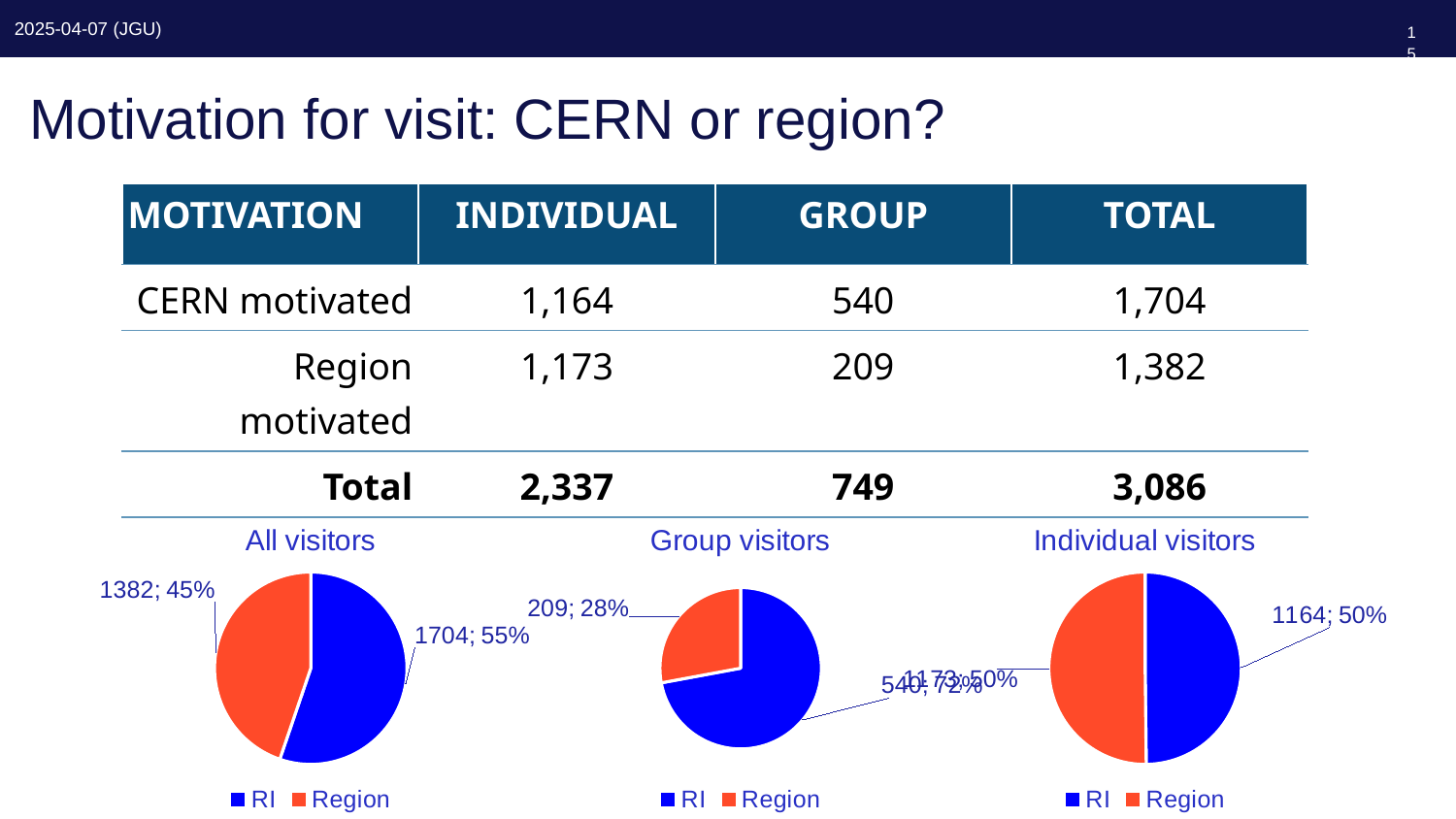
In the "All visitors" pie chart, what is the difference between the RI value and the Region value? 322 In the "All visitors" pie chart, what share of the pie is Region? 45% What kind of chart is the "All visitors" chart? pie chart In the "Group visitors" pie chart, which slice is the largest? RI In the "All visitors" pie chart, what colour represents RI? blue In the "All visitors" pie chart, what is the value for RI? 1704 How many entries does the legend of the "Group visitors" pie chart list? 2 How many pie charts are shown on the slide? 3 In the "Individual visitors" pie chart, what is the value for RI? 1164 In the "Group visitors" pie chart, what share of the pie is Region? 28% In the "Group visitors" pie chart, what is the value for Region? 209 In the "All visitors" pie chart, which slice is larger, RI or Region? RI